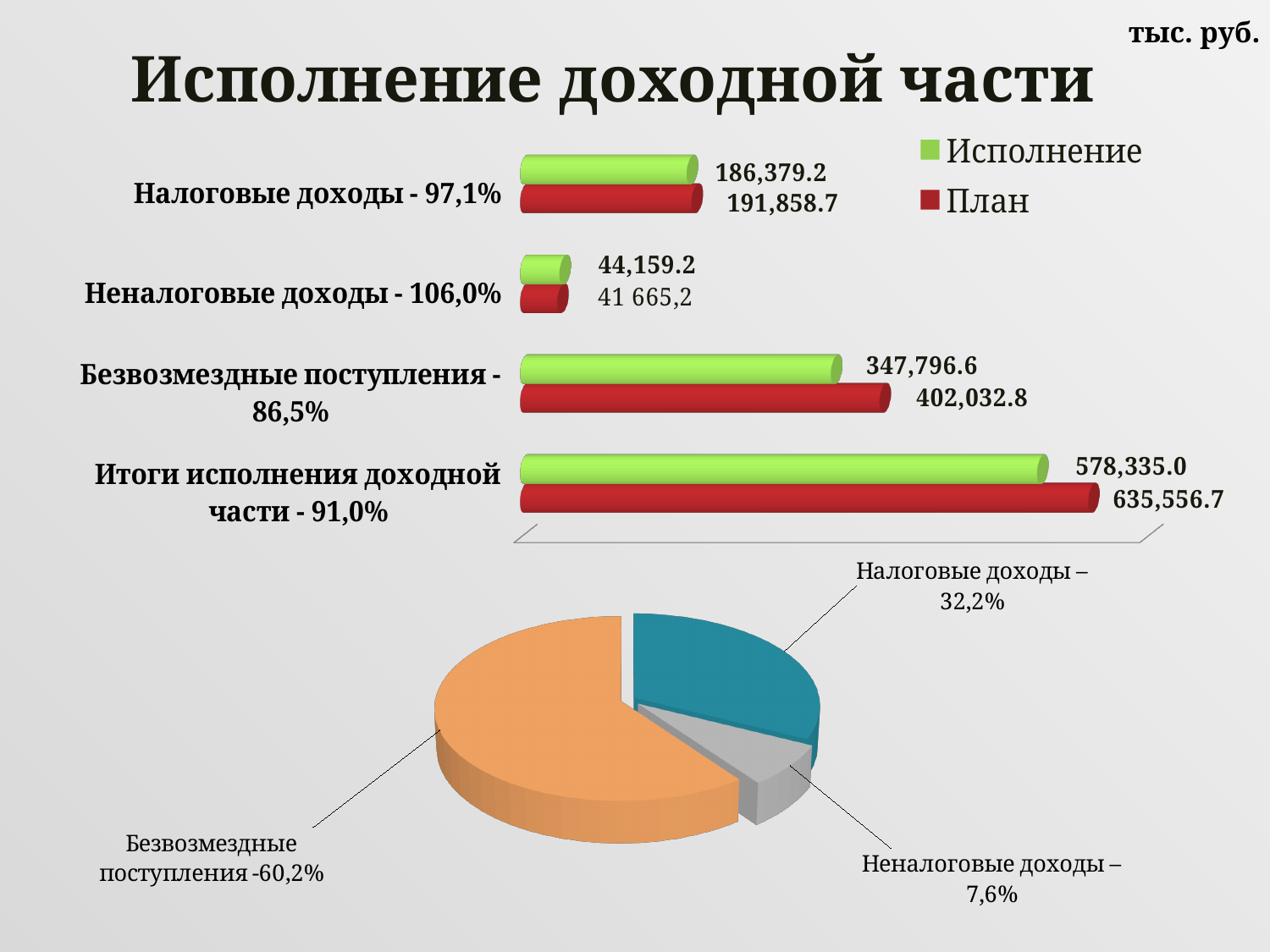
In the pie chart, what share does Безвозмездные поступления have? 60,2% In the bar chart, what is the План value for Итоги исполнения доходной части? 635,556.7 In the bar chart, which category has the lowest Исполнение value? Неналоговые доходы How many slices does the pie chart have? 3 How many series does the legend of the bar chart list? 2 In the bar chart, what is the Исполнение value for Неналоговые доходы? 44,159.2 In the bar chart, which category has the highest План value? Итоги исполнения доходной части In the bar chart, for Неналоговые доходы, which is larger: Исполнение or План? Исполнение In the bar chart, what is the difference between the План and Исполнение values for Безвозмездные поступления? 54,236.2 What type of chart is the top chart on the slide? Bar chart In the bar chart, what is the План value for Безвозмездные поступления? 402,032.8 In the bar chart, what is the Исполнение value for Налоговые доходы? 186,379.2